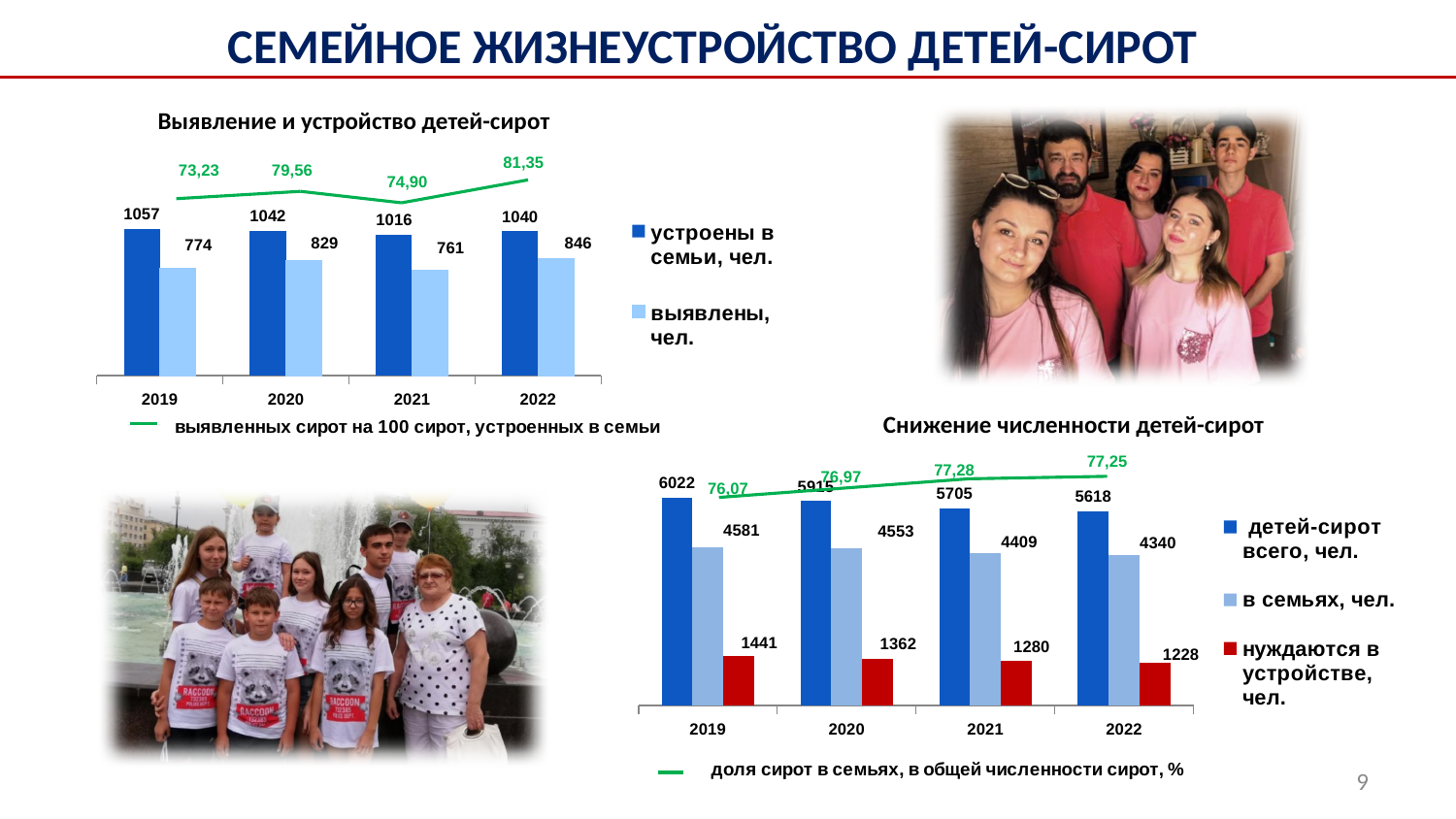
In the chart 'Выявление и устройство детей-сирот', in which year is the line 'выявленных сирот на 100 сирот, устроенных в семьи' highest? 2022 In the chart 'Снижение численности детей-сирот', how many years are shown on the x axis? 4 In the chart 'Выявление и устройство детей-сирот', what is the value for 'устроены в семьи, чел.' in 2019? 1057 In the chart 'Выявление и устройство детей-сирот', what is the value for 'выявлены, чел.' in 2022? 846 In the chart 'Выявление и устройство детей-сирот', in which year is the value for 'выявлены, чел.' lowest? 2021 What kind of chart is 'Снижение численности детей-сирот'? bar chart with a line In the chart 'Выявление и устройство детей-сирот', what is the difference between 'устроены в семьи, чел.' and 'выявлены, чел.' in 2020? 213 In the chart 'Снижение численности детей-сирот', what is the value for 'нуждаются в устройстве, чел.' in 2021? 1280 In the chart 'Снижение численности детей-сирот', what is the difference between 'нуждаются в устройстве, чел.' in 2019 and in 2022? 213 In the chart 'Снижение численности детей-сирот', what is the value for 'в семьях, чел.' in 2019? 4581 In the chart 'Выявление и устройство детей-сирот', how many series does the legend list (including the line)? 3 In the chart 'Снижение численности детей-сирот', does the value for 'детей-сирот всего, чел.' rise or fall from 2019 to 2022? fall